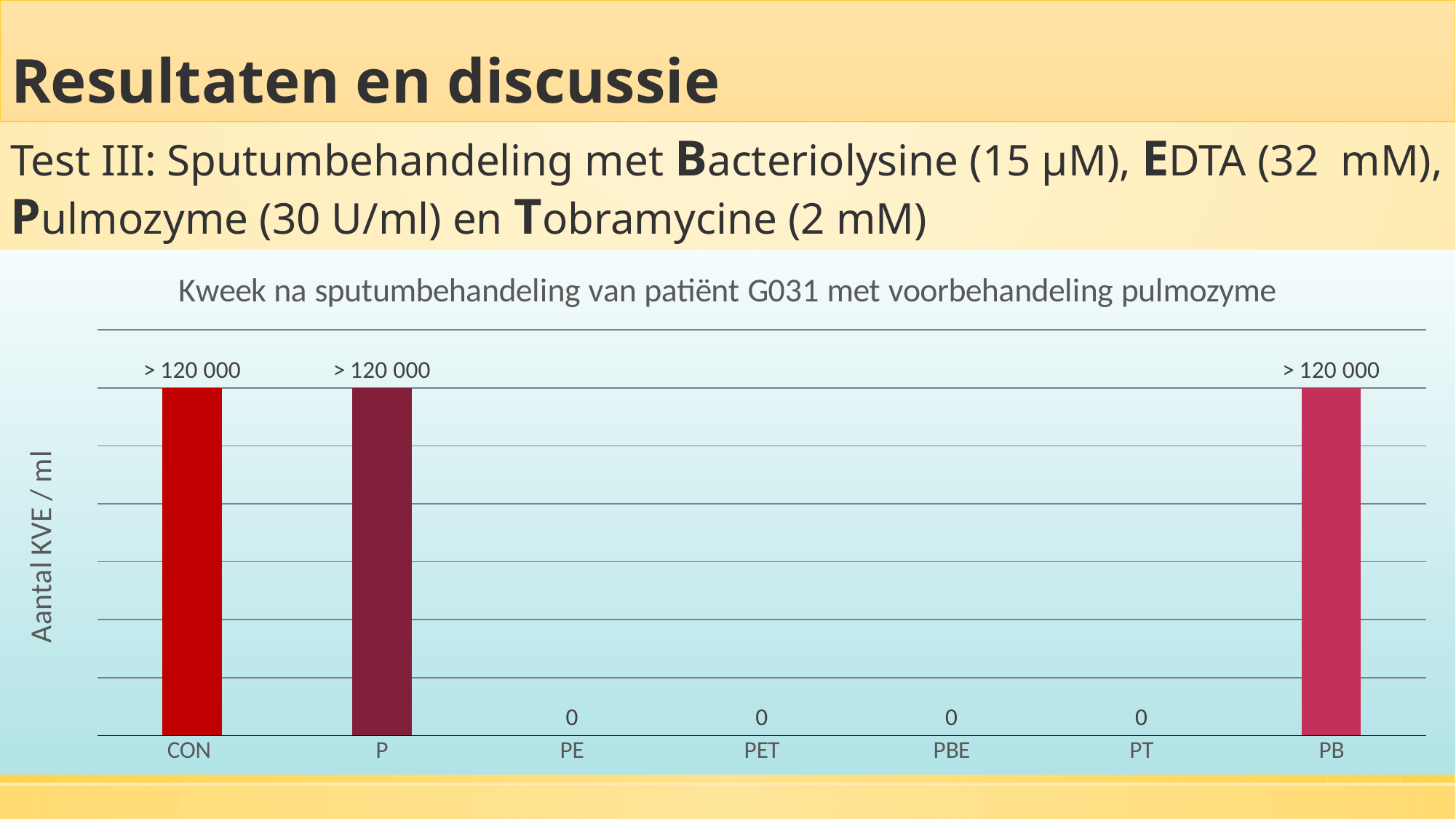
Which is larger, the value for CON or the value for PET? CON What value is labelled for the P bar? > 120 000 What is the title of the chart? Kweek na sputumbehandeling van patiënt G031 met voorbehandeling pulmozyme Which is larger, the value for PBE or the value for PB? PB How many categories are shown on the x axis of the chart? 7 What kind of chart is shown on the slide? Bar chart What value is labelled for the PE category? 0 What is the label on the vertical axis of the chart? Aantal KVE / ml What value is labelled for the PB bar? > 120 000 What value is labelled for the CON bar? > 120 000 How many categories have a labelled value of 0? 4 What value is labelled for the PT category? 0